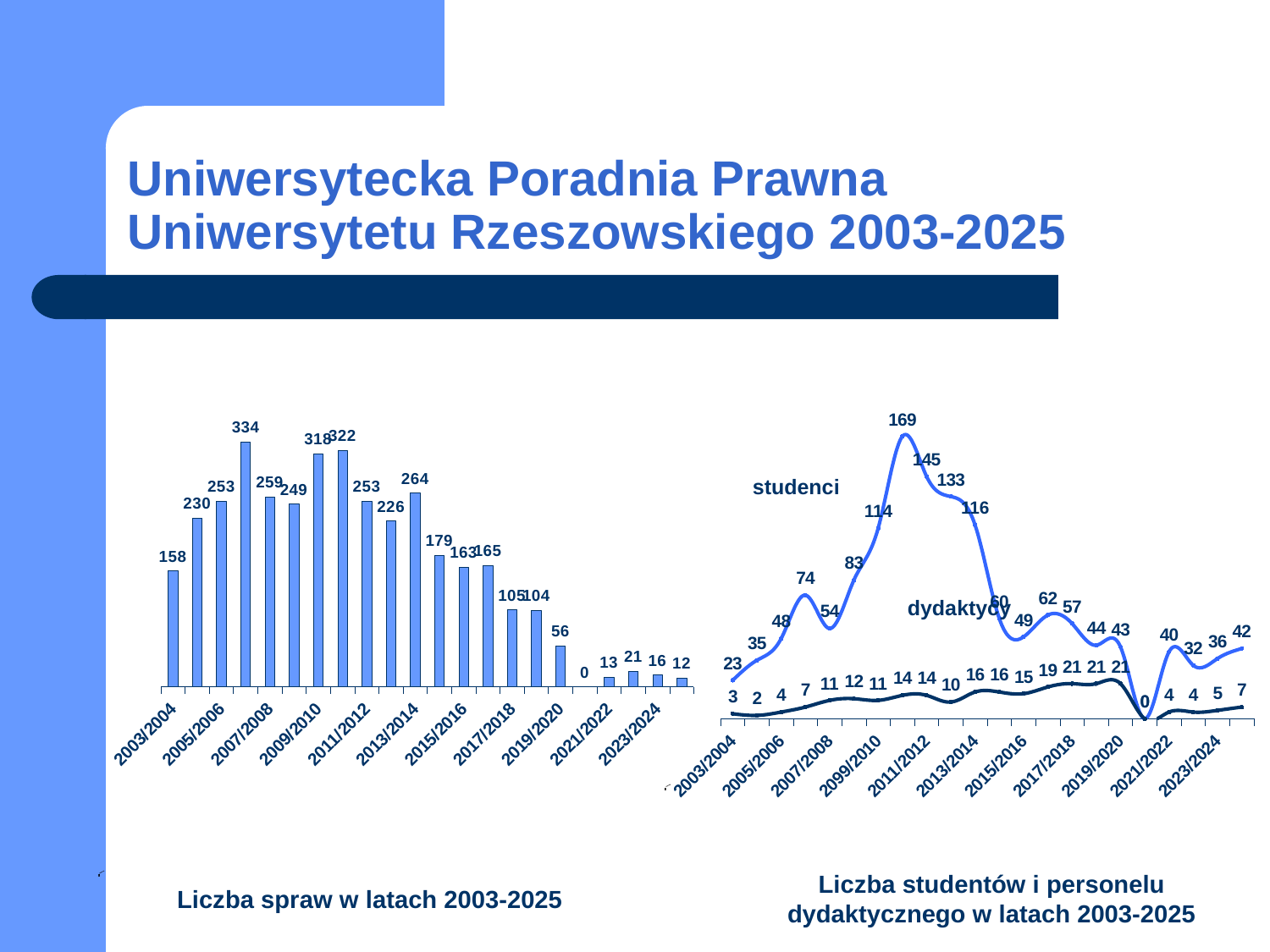
How many series are plotted in the right chart 'Liczba studentów i personelu dydaktycznego w latach 2003-2025'? 2 In the right chart, what is the highest value of the 'studenci' series? 169 How many bars are plotted in the left chart 'Liczba spraw w latach 2003-2025'? 22 In the left chart 'Liczba spraw w latach 2003-2025', which is larger: the value for 2003/2004 or the value for 2005/2006? 2005/2006 In the left chart 'Liczba spraw w latach 2003-2025', what is the lowest value shown? 0 In the right chart, what is the 'studenci' value for 2003/2004? 23 In the left chart 'Liczba spraw w latach 2003-2025', what is the value for 2003/2004? 158 In the right chart, what is the 'dydaktycy' value for 2003/2004? 3 What kind of chart is the left chart, 'Liczba spraw w latach 2003-2025'? bar chart What kind of chart is the right chart, 'Liczba studentów i personelu dydaktycznego w latach 2003-2025'? line chart In the left chart 'Liczba spraw w latach 2003-2025', what is the difference between the values for 2005/2006 and 2003/2004? 95 In the left chart 'Liczba spraw w latach 2003-2025', what is the highest value shown? 334